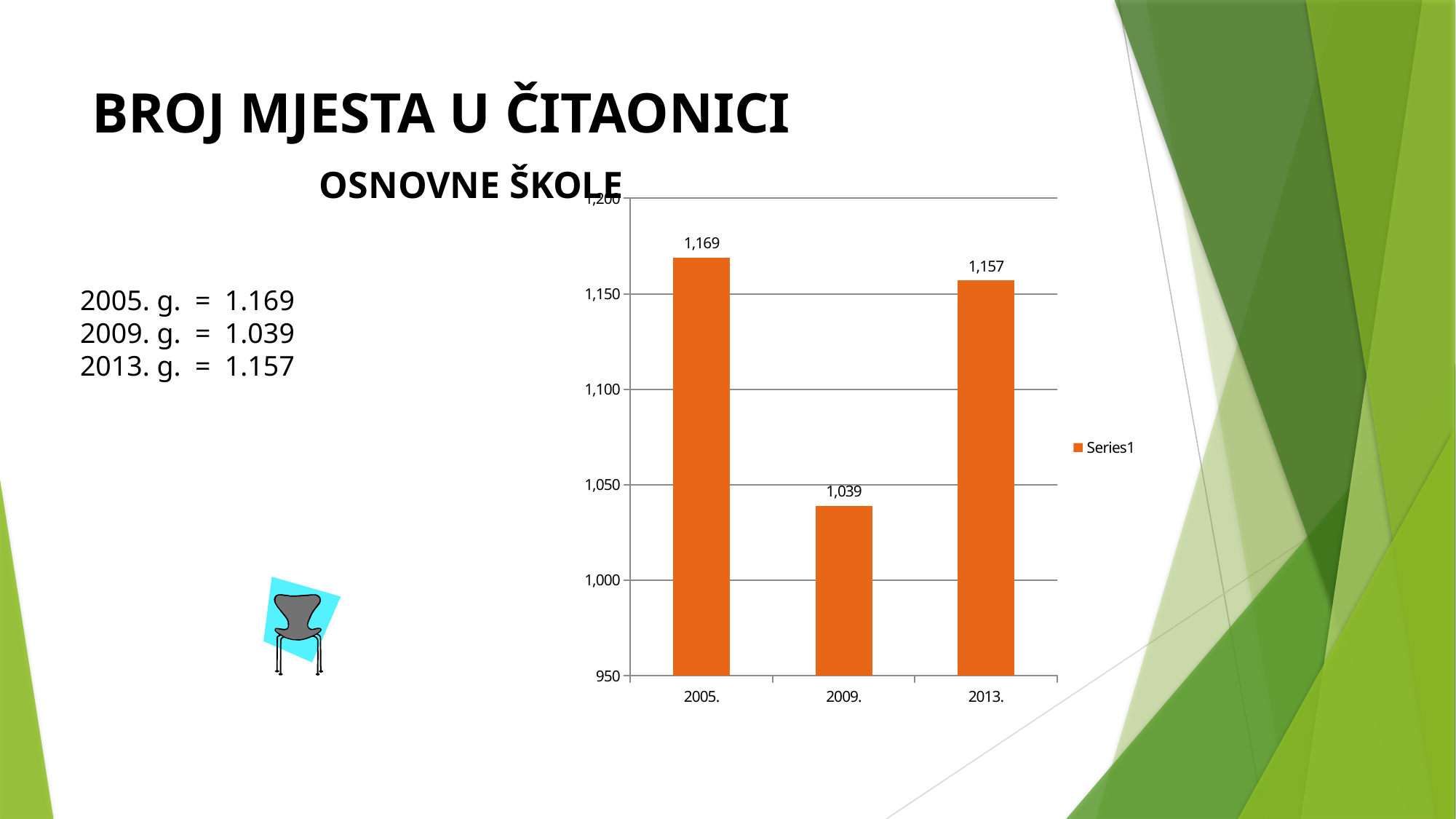
Which year has the highest value in the chart? 2005. Which year has the lowest value in the chart? 2009. What is the value for 2005. in the chart? 1,169 What is the value for 2009. in the chart? 1,039 What is the difference between the values for 2005. and 2009.? 130 What kind of chart is shown on the slide? bar chart What is the value for 2013. in the chart? 1,157 What is the name of the series listed in the chart legend? Series1 How many bars are shown in the chart? 3 Is the value for 2009. greater or less than 1,050? less What is the difference between the values for 2005. and 2013.? 12 Which is larger, the value for 2009. or the value for 2013.? 2013.